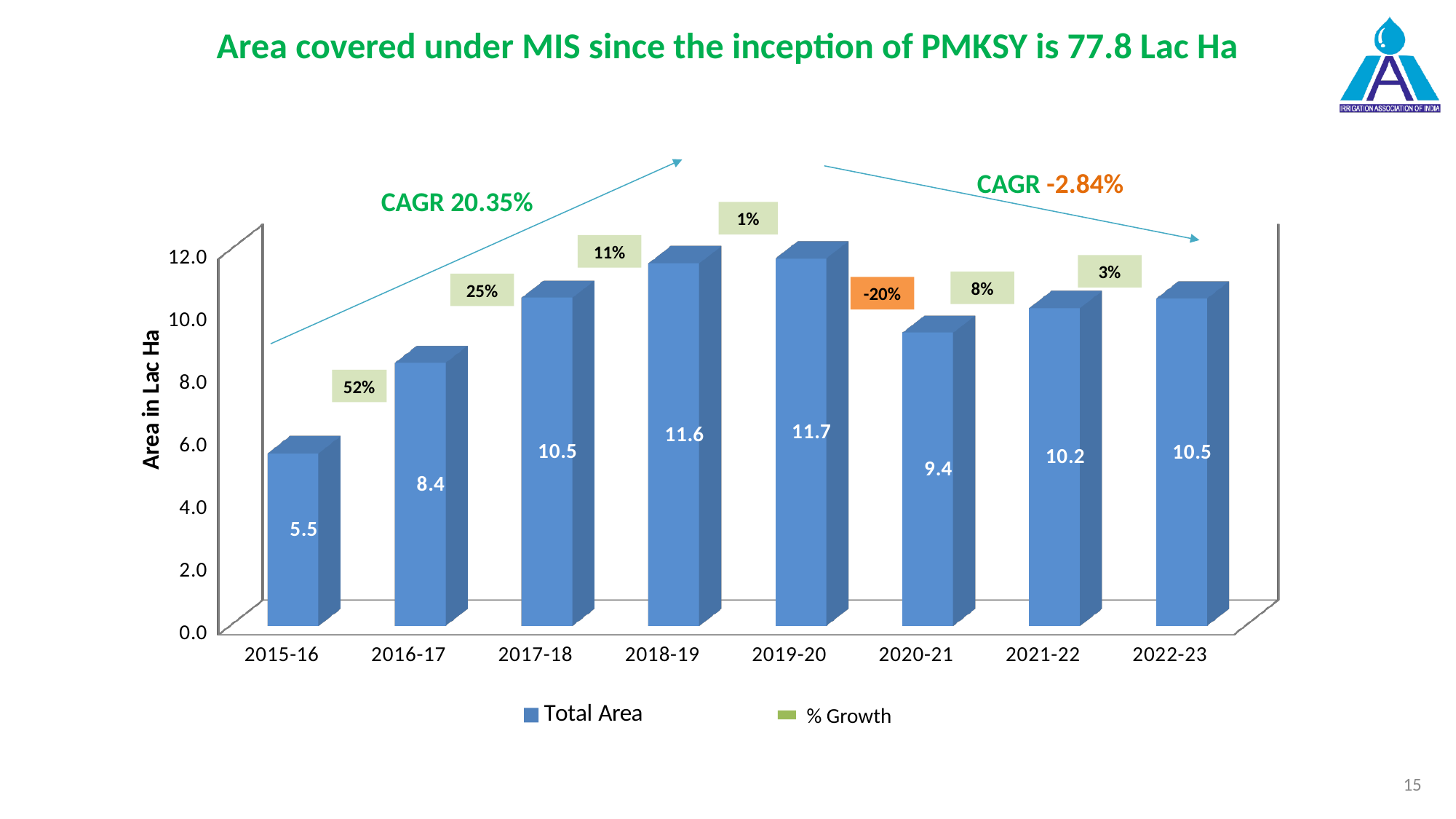
Which year has the larger Total Area, 2016-17 or 2021-22? 2021-22 Which year has the highest Total Area? 2019-20 Which year has the lowest Total Area? 2015-16 What is the % Growth label shown for 2016-17? 52% What is the difference in Total Area between 2019-20 and 2020-21? 2.3 How many series does the legend list? 2 How many years are shown on the x axis? 8 What is the Total Area value for 2018-19? 11.6 What is the % Growth label shown for 2020-21? -20% What is the Total Area value for 2015-16? 5.5 What kind of chart is shown on the slide? Bar chart What is the y-axis label of the chart? Area in Lac Ha